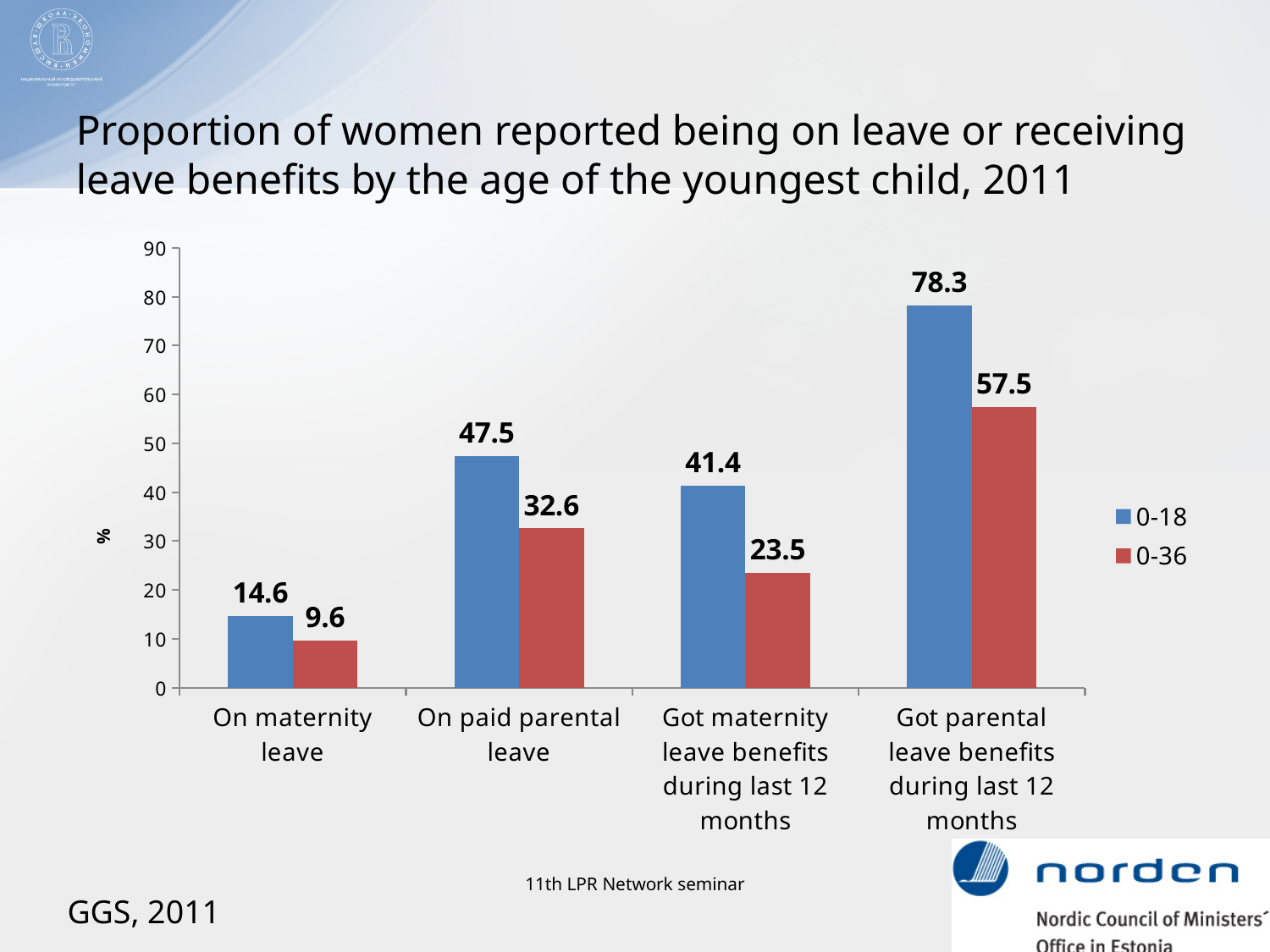
Is the 0-18 value for 'Got maternity leave benefits during last 12 months' greater or less than 40? greater What kind of chart is shown on the slide? Bar chart Which is larger in the 'On paid parental leave' category: the 0-18 value or the 0-36 value? 0-18 What is the value for the 0-18 series in the 'On maternity leave' category? 14.6 How many categories are shown on the x axis? 4 Which category has the lowest value for the 0-36 series? On maternity leave What is the value for the 0-36 series in the 'On paid parental leave' category? 32.6 Which category has the highest value for the 0-18 series? Got parental leave benefits during last 12 months What is the value for the 0-36 series in the 'Got maternity leave benefits during last 12 months' category? 23.5 What is the label on the vertical axis? % What is the difference between the 0-18 and 0-36 values in the 'Got parental leave benefits during last 12 months' category? 20.8 How many series does the legend list? 2